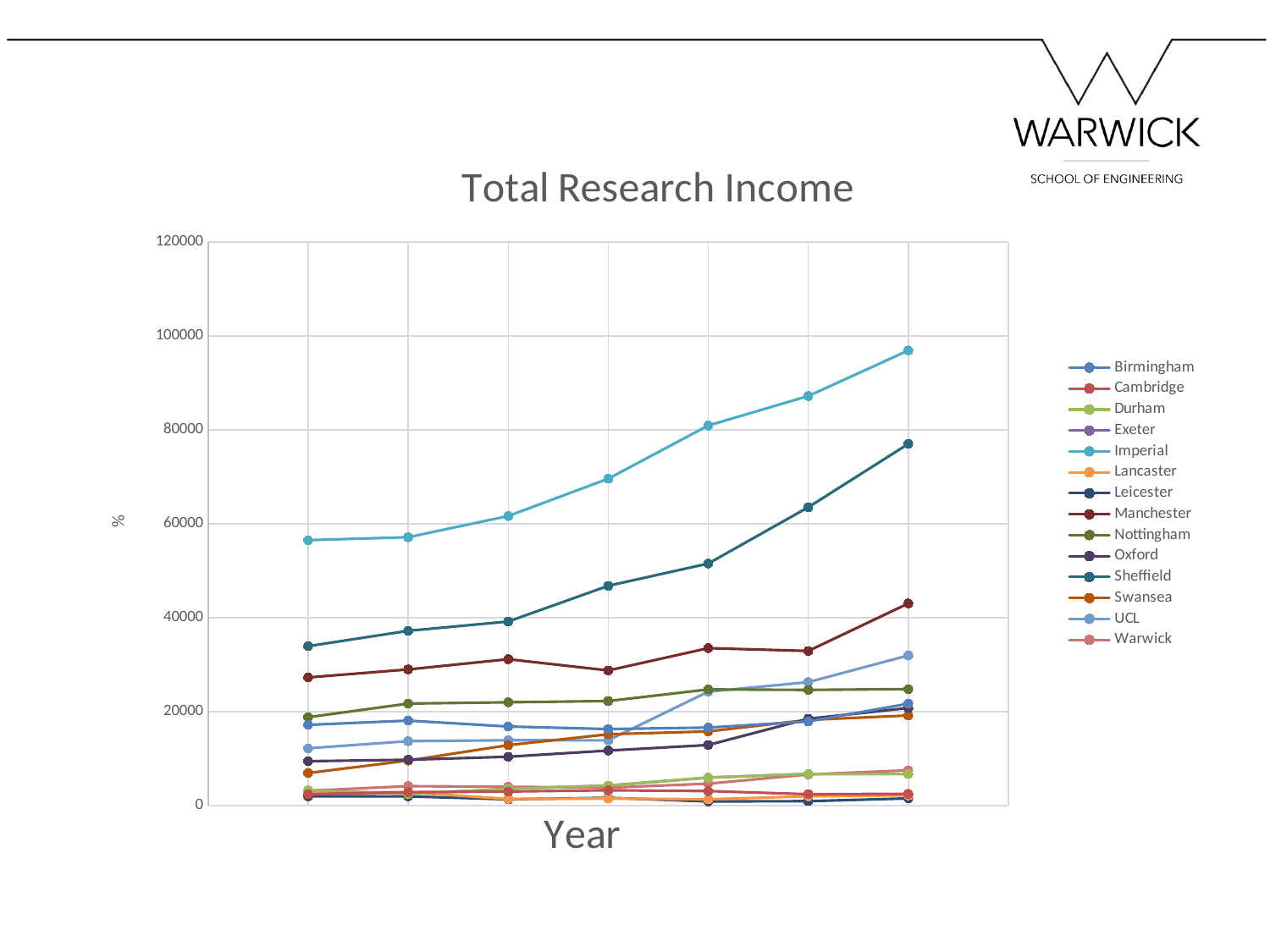
What is the label on the x axis of the chart? Year Do the values for Sheffield rise or fall along the x axis? rise How many series does the legend list? 14 Is the last value for Manchester greater or less than 60000? less Is the last value for Imperial greater or less than 80000? greater Do the values for Imperial rise or fall along the x axis? rise What is the title of the chart? Total Research Income Which series has the highest values across the chart? Imperial Is the first value for Sheffield greater or less than 40000? less How many data points does each line have? 7 What kind of chart is shown on the slide? line chart At the last point on the x axis, which is larger: Imperial or Sheffield? Imperial